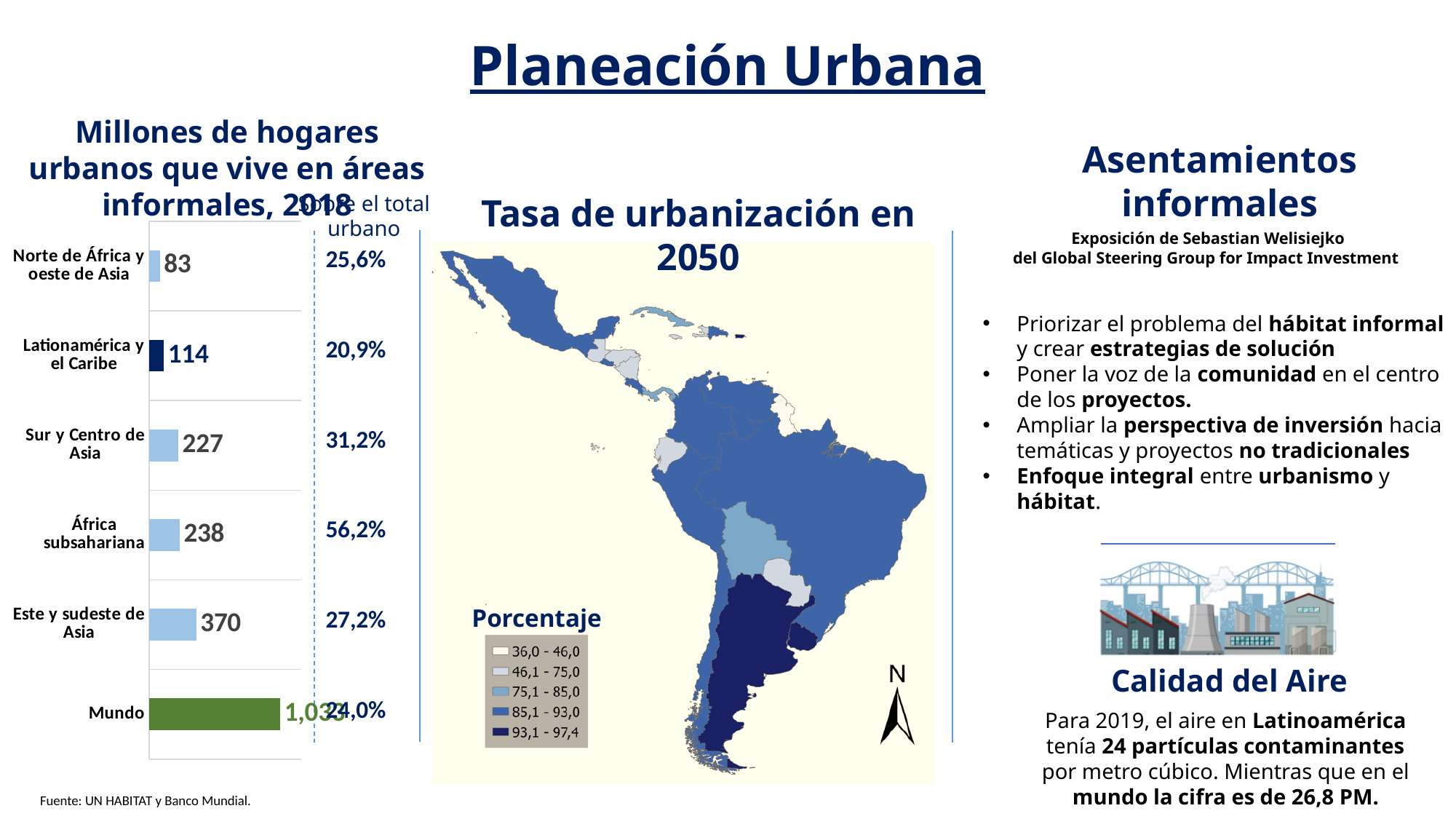
In the bar chart 'Millones de hogares urbanos que vive en áreas informales, 2018', which is larger: Sur y Centro de Asia or África subsahariana? África subsahariana In the bar chart 'Millones de hogares urbanos que vive en áreas informales, 2018', what is the value for Latinoamérica y el Caribe? 114 How many categories are shown in the bar chart 'Millones de hogares urbanos que vive en áreas informales, 2018'? 6 In the bar chart 'Millones de hogares urbanos que vive en áreas informales, 2018', what is the value for Sur y Centro de Asia? 227 What type of chart is 'Millones de hogares urbanos que vive en áreas informales, 2018'? Bar chart In the bar chart 'Millones de hogares urbanos que vive en áreas informales, 2018', which category has the lowest value? Norte de África y oeste de Asia In the bar chart 'Millones de hogares urbanos que vive en áreas informales, 2018', what is the value for Norte de África y oeste de Asia? 83 In the bar chart 'Millones de hogares urbanos que vive en áreas informales, 2018', what is the difference between Este y sudeste de Asia and Latinoamérica y el Caribe? 256 In the bar chart 'Millones de hogares urbanos que vive en áreas informales, 2018', what is the difference between África subsahariana and Sur y Centro de Asia? 11 In the bar chart 'Millones de hogares urbanos que vive en áreas informales, 2018', which category has the longest bar? Mundo In the bar chart 'Millones de hogares urbanos que vive en áreas informales, 2018', what is the value for Este y sudeste de Asia? 370 In the bar chart 'Millones de hogares urbanos que vive en áreas informales, 2018', what is the value for África subsahariana? 238